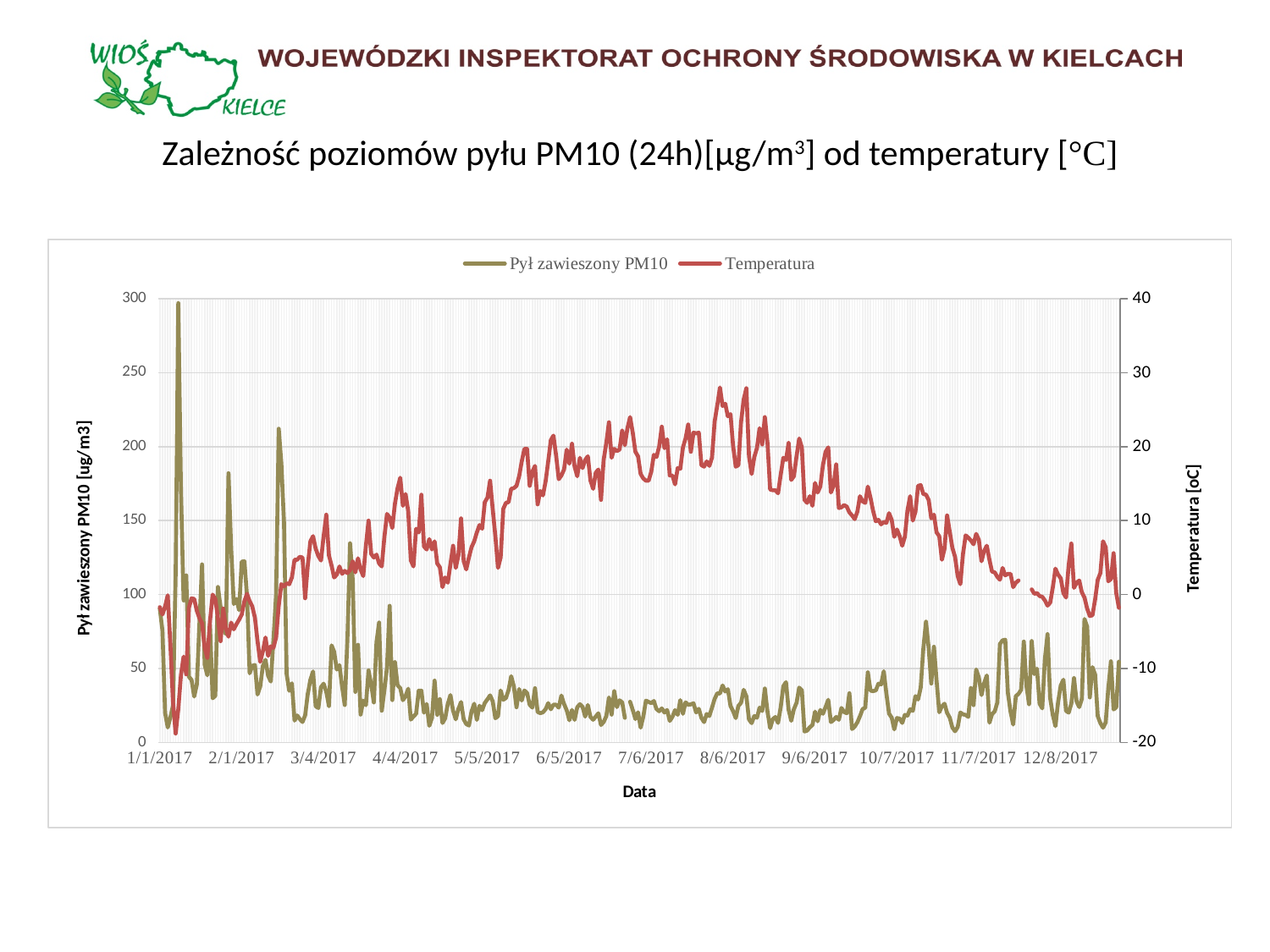
Is the highest temperature value in August 2017 greater or less than 20? greater Is the lowest temperature value in January 2017 greater or less than -10? less What kind of chart is shown on the slide? line chart Is the highest PM10 value in January 2017 greater or less than 250? greater Which series is drawn in red? Temperatura Does the temperature series generally rise or fall from August to December 2017? fall Does the temperature series generally rise or fall from January to August 2017? rise Which is higher: the PM10 peak in January 2017 or the PM10 peak in late February 2017? the January 2017 peak How many series does the chart legend list? 2 What are the two series named in the chart legend? Pył zawieszony PM10 and Temperatura